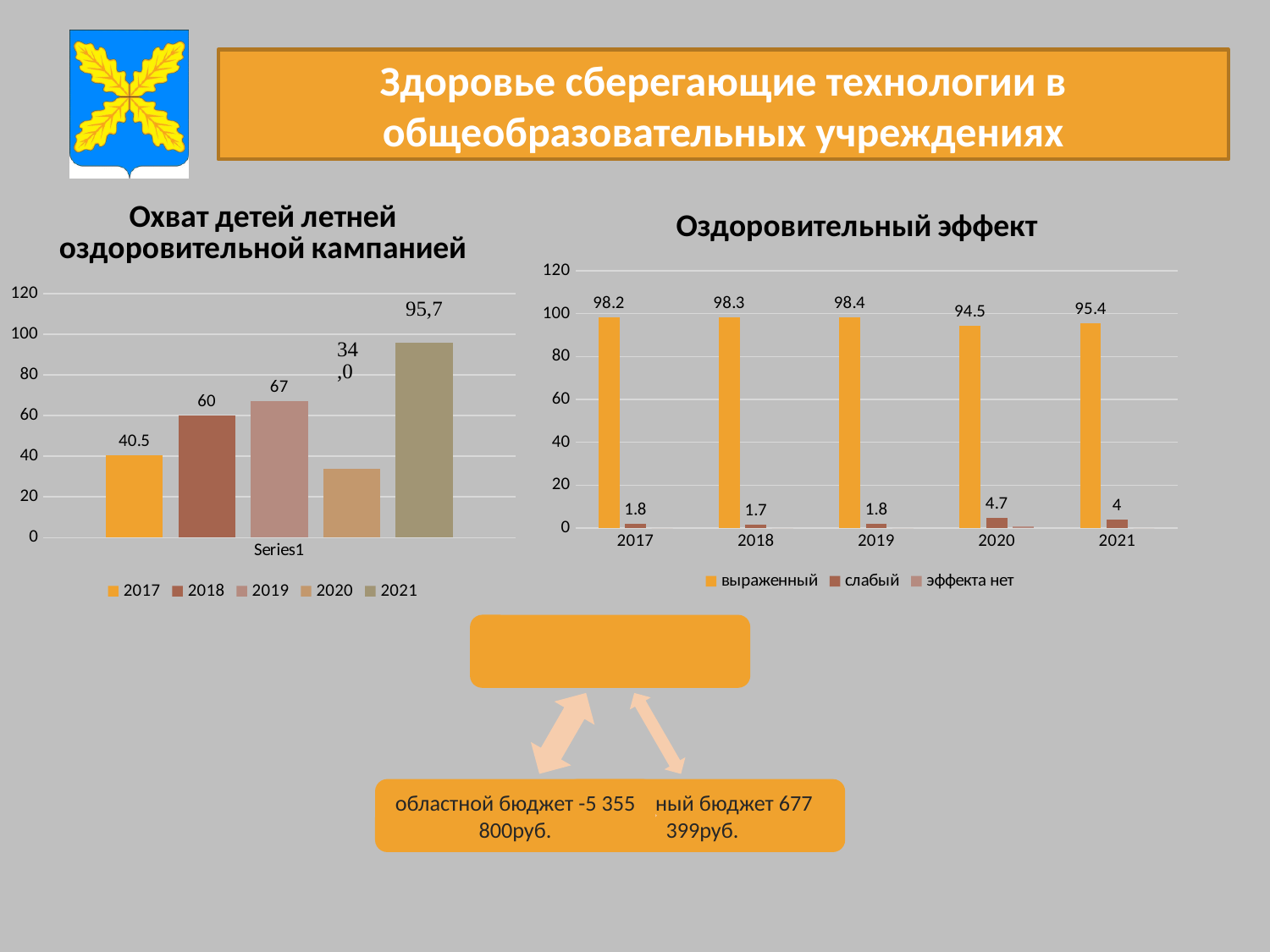
How many years are shown on the x axis of the chart 'Оздоровительный эффект'? 5 In the chart 'Оздоровительный эффект', what is the value of 'выраженный' for 2020? 94.5 How many series does the legend of the chart 'Оздоровительный эффект' list? 3 In the chart 'Охват детей летней оздоровительной кампанией', what is the value for 2021? 95,7 In the chart 'Охват детей летней оздоровительной кампанией', what is the value for 2017? 40.5 In the chart 'Охват детей летней оздоровительной кампанией', what is the difference between the values for 2018 and 2017? 19.5 In the chart 'Охват детей летней оздоровительной кампанией', which year has the lowest value? 2020 In the chart 'Оздоровительный эффект', what is the difference between the 'выраженный' values for 2017 and 2020? 3.7 In the chart 'Оздоровительный эффект', what is the value of 'слабый' for 2020? 4.7 In the chart 'Охват детей летней оздоровительной кампанией', which year has the highest value? 2021 How many series does the legend of the chart 'Охват детей летней оздоровительной кампанией' list? 5 In the chart 'Оздоровительный эффект', in which year is the 'слабый' value highest? 2020